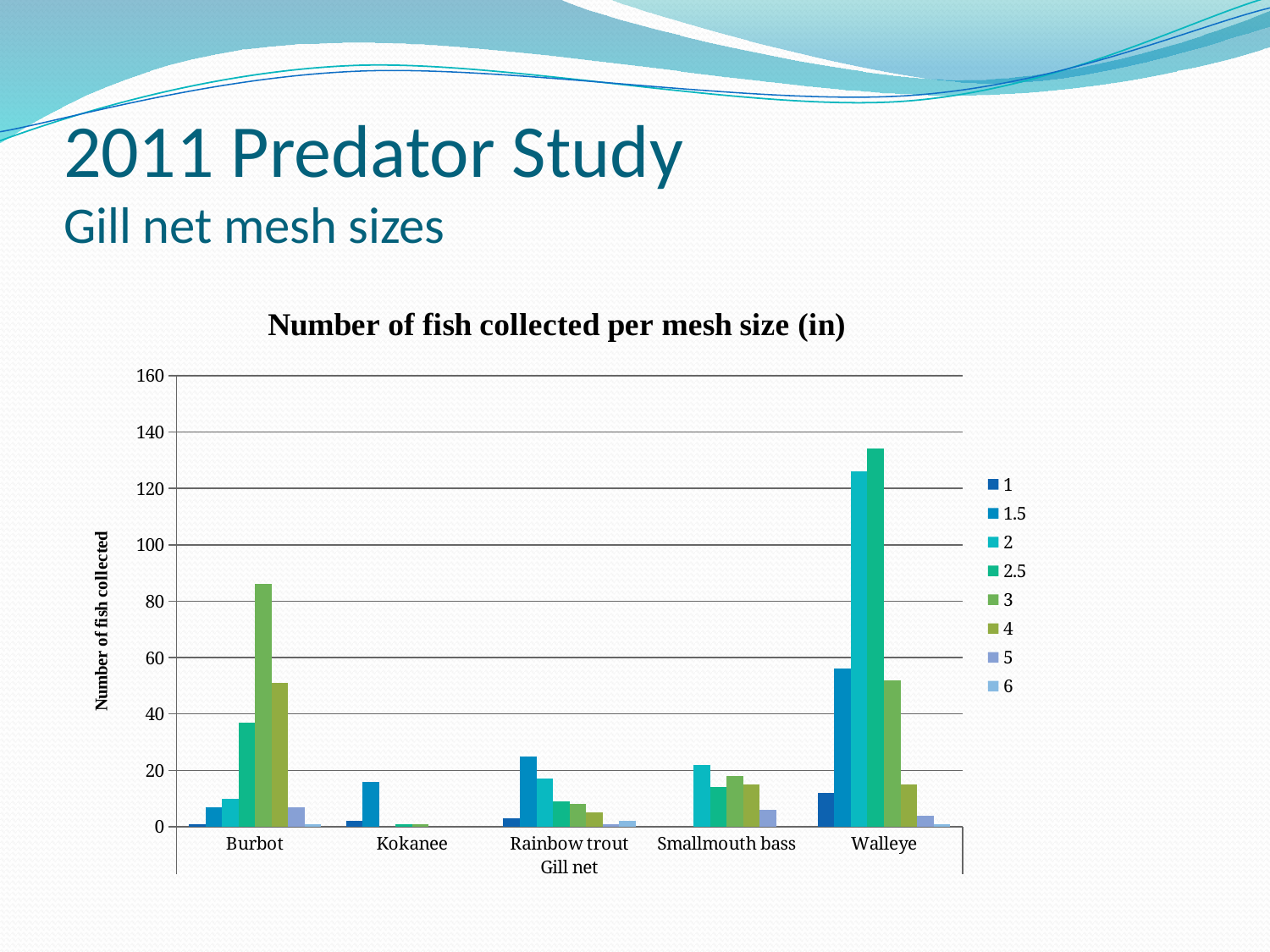
How many fish species categories are shown on the x axis? 5 What is the title of the chart? Number of fish collected per mesh size (in) What is the label of the vertical axis? Number of fish collected Is the value for Walleye at mesh size 2.5 greater or less than 120? greater For Walleye, which mesh size collected the most fish? 2.5 Which is larger: the value for Burbot at mesh size 4 or the value for Burbot at mesh size 2.5? Burbot at mesh size 4 Which species has the tallest bar in the chart? Walleye What type of chart is shown on the slide? bar chart For Burbot, which mesh size collected the most fish? 3 Is the value for Kokanee at mesh size 1.5 greater or less than 20? less Is the value for Burbot at mesh size 3 greater or less than 80? greater How many mesh sizes does the legend list? 8